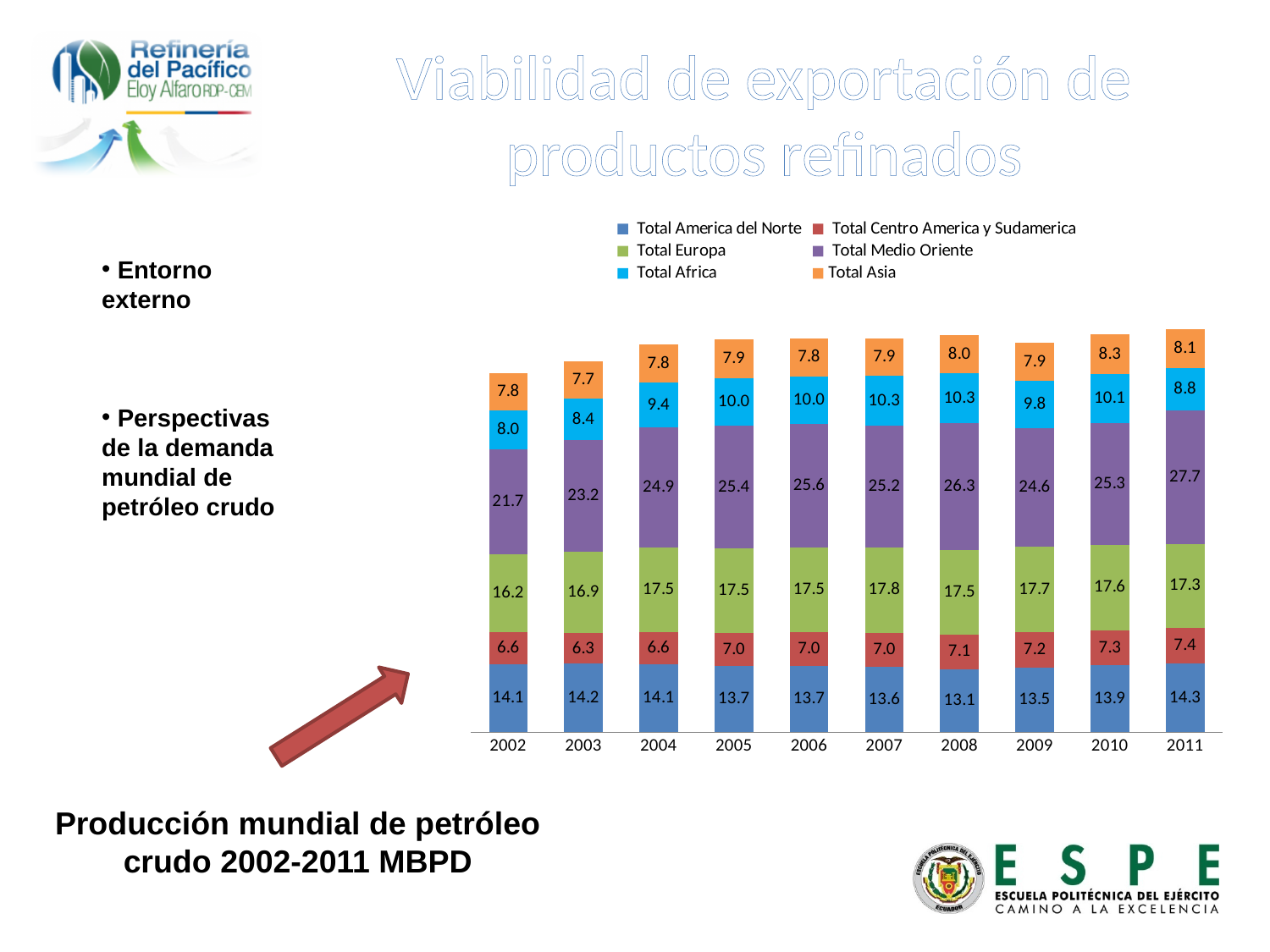
How many years are shown on the x axis? 10 What is the value for Total Medio Oriente in 2011? 27.7 How many series does the legend list? 6 What is the value for Total Africa in 2007? 10.3 What is the total of the stacked bar for 2002? 74.4 In which year is the value for Total Medio Oriente highest? 2011 What kind of chart is shown on the slide? Stacked bar chart What is the value for Total America del Norte in 2002? 14.1 Which is larger, Total Europa in 2002 or Total Europa in 2011? Total Europa in 2011 What is the difference between the Total Medio Oriente values in 2011 and 2002? 6.0 In which year is the value for Total America del Norte lowest? 2008 Which series is shown in orange in the legend? Total Asia